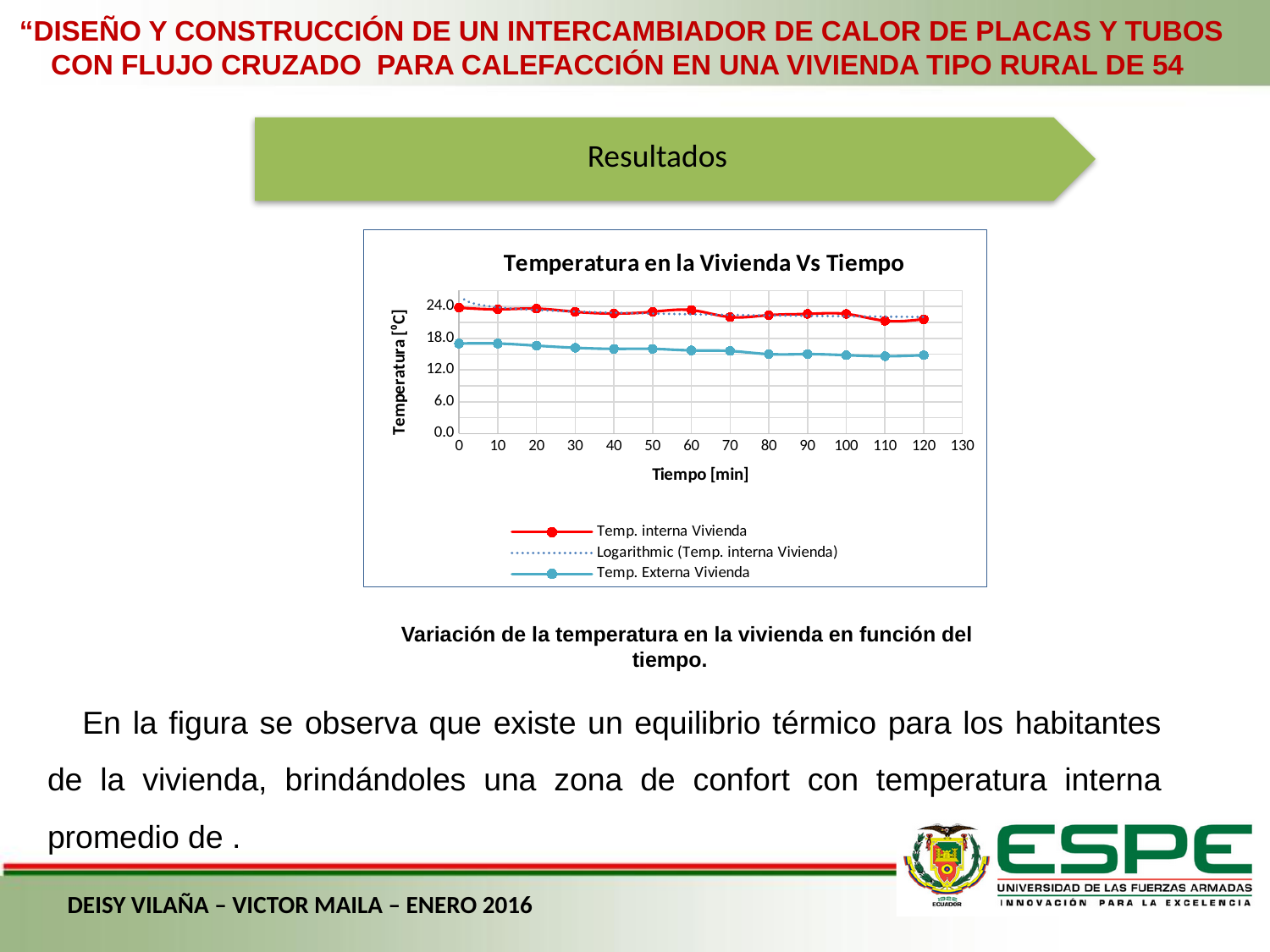
Is the value for Temp. Externa Vivienda at 120 min greater or less than 12.0? greater Does the Temp. interna Vivienda series generally rise or fall from 0 to 120 min? fall How many entries does the chart legend list? 3 How many data points does the Temp. interna Vivienda series have? 13 Is the value for Temp. interna Vivienda at 120 min greater or less than 18.0? greater Is the value for Temp. Externa Vivienda at 0 min greater or less than 18.0? less At 60 min, which series has the larger value, Temp. interna Vivienda or Temp. Externa Vivienda? Temp. interna Vivienda What kind of chart is shown on the slide? line chart What is the label of the x axis? Tiempo [min] Does the Temp. Externa Vivienda series rise or fall as time increases from 0 to 120 min? fall What is the title of the chart? Temperatura en la Vivienda Vs Tiempo